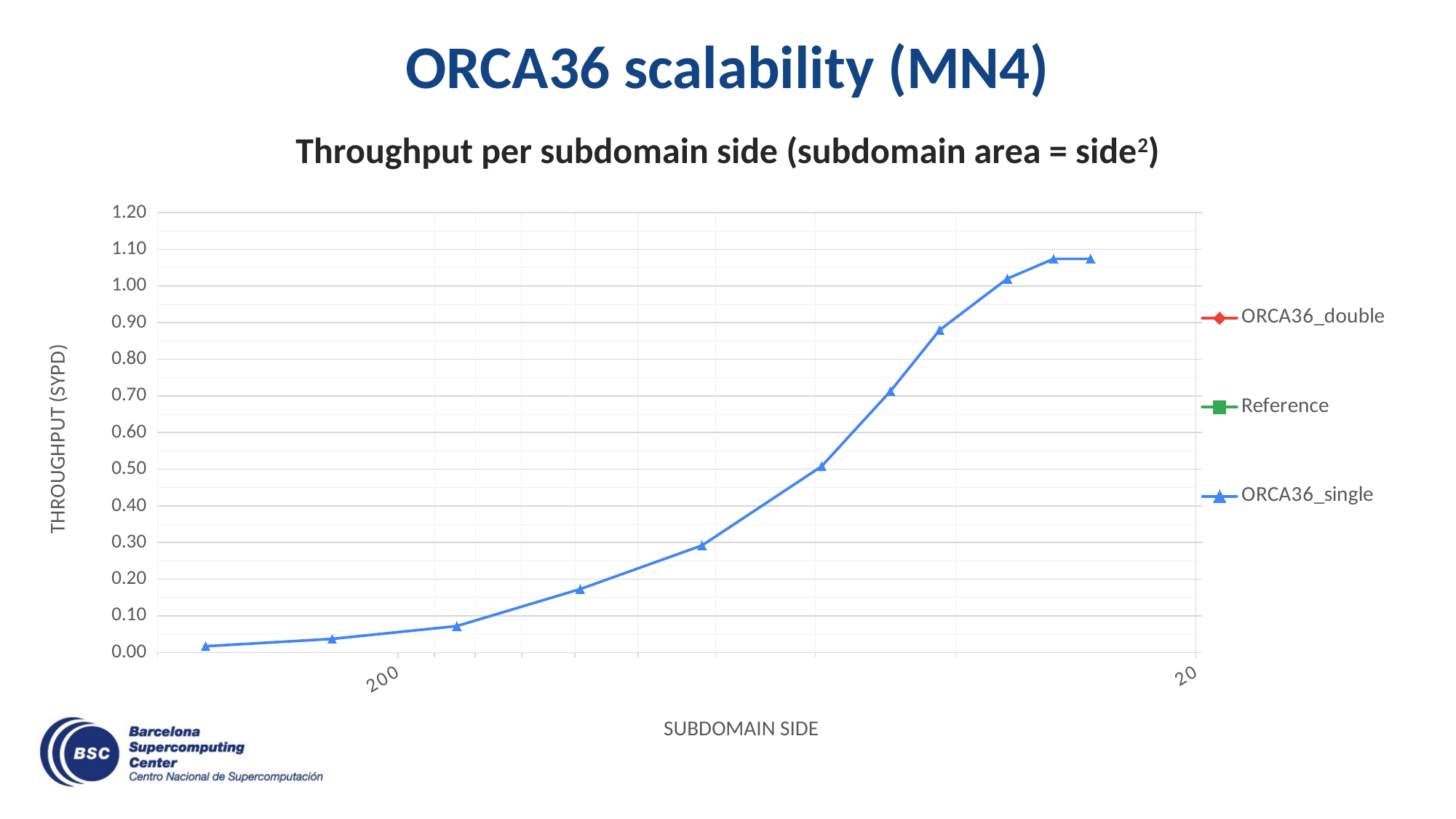
How many data points are plotted on the ORCA36_single line? 11 What kind of chart is shown on the slide? line chart Does the ORCA36_single throughput rise or fall as the subdomain side increases along the x axis? falls Which is larger on the ORCA36_single line: the leftmost point or the rightmost point? the rightmost point Is the first (leftmost) point on the ORCA36_single line greater or less than 0.10? less What is the title of the chart? Throughput per subdomain side (subdomain area = side²) Is the highest value on the ORCA36_single line greater or less than 1.00? greater What is the label of the vertical axis? THROUGHPUT (SYPD) Is the last (rightmost) point on the ORCA36_single line greater or less than 1.10? less Which legend series is actually plotted as a visible line on the chart? ORCA36_single How many series does the legend list? 3